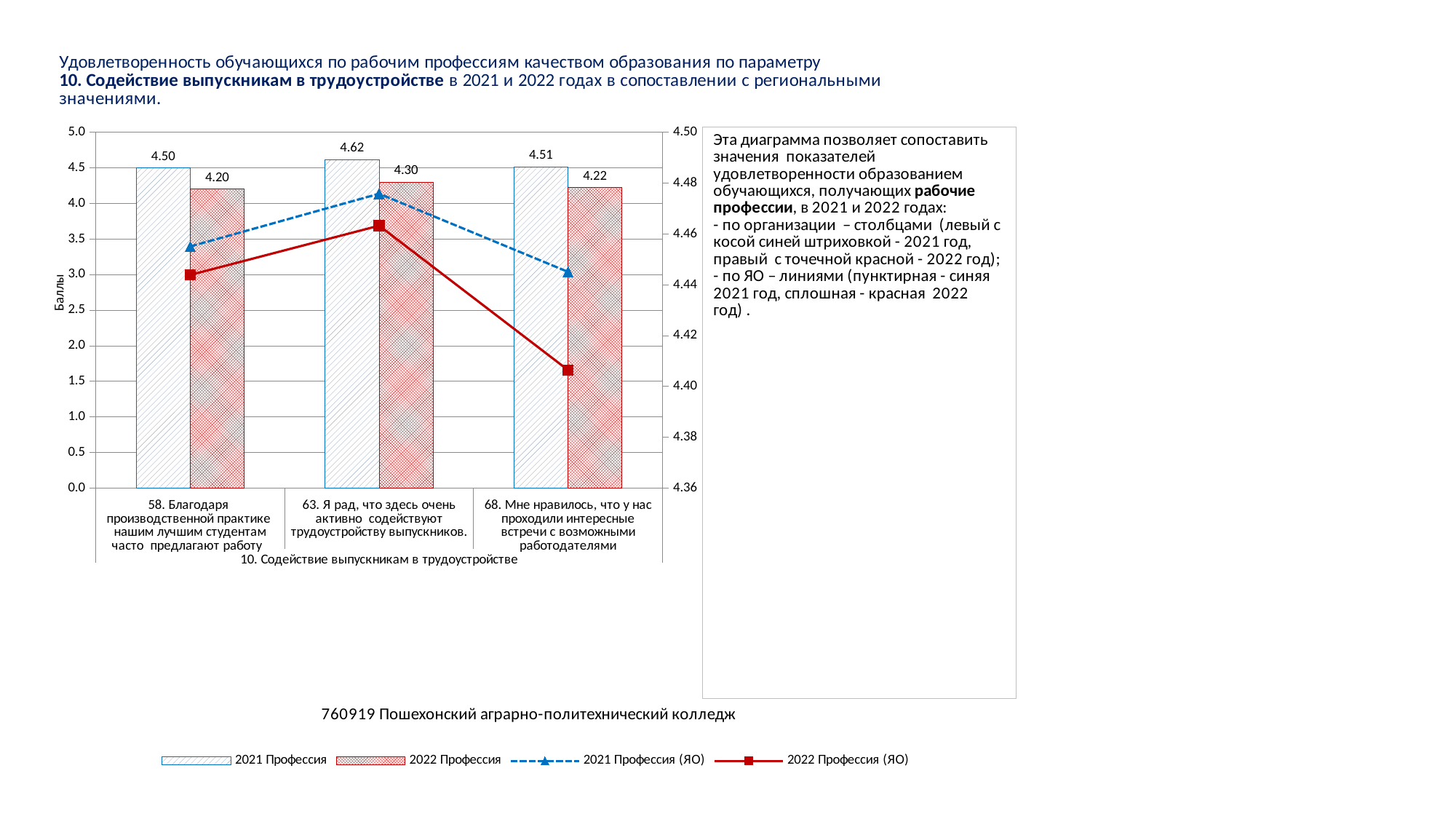
Which category has the lowest 2022 Профессия bar? 58. Благодаря производственной практике нашим лучшим студентам часто предлагают работу On the right-hand axis, is the 2021 Профессия (ЯО) line value for category 63 greater or less than 4.46? greater How many series does the chart legend list? 4 On the right-hand axis, is the 2022 Профессия (ЯО) line value for category 68 greater or less than 4.42? less What is the value of the 2022 Профессия bar for category "68. Мне нравилось, что у нас проходили интересные встречи с возможными работодателями"? 4.22 What is the value of the 2021 Профессия bar for category "58. Благодаря производственной практике нашим лучшим студентам часто предлагают работу"? 4.50 Which category has the highest 2021 Профессия bar? 63. Я рад, что здесь очень активно содействуют трудоустройству выпускников. For category 58, which bar is larger: 2021 Профессия or 2022 Профессия? 2021 Профессия How many categories are shown on the x axis of the chart? 3 What is the difference between the 2021 Профессия and 2022 Профессия bars for category 63? 0.32 What is the value of the 2022 Профессия bar for category "63. Я рад, что здесь очень активно содействуют трудоустройству выпускников."? 4.30 Does the 2022 Профессия (ЯО) line rise or fall between category 63 and category 68? falls